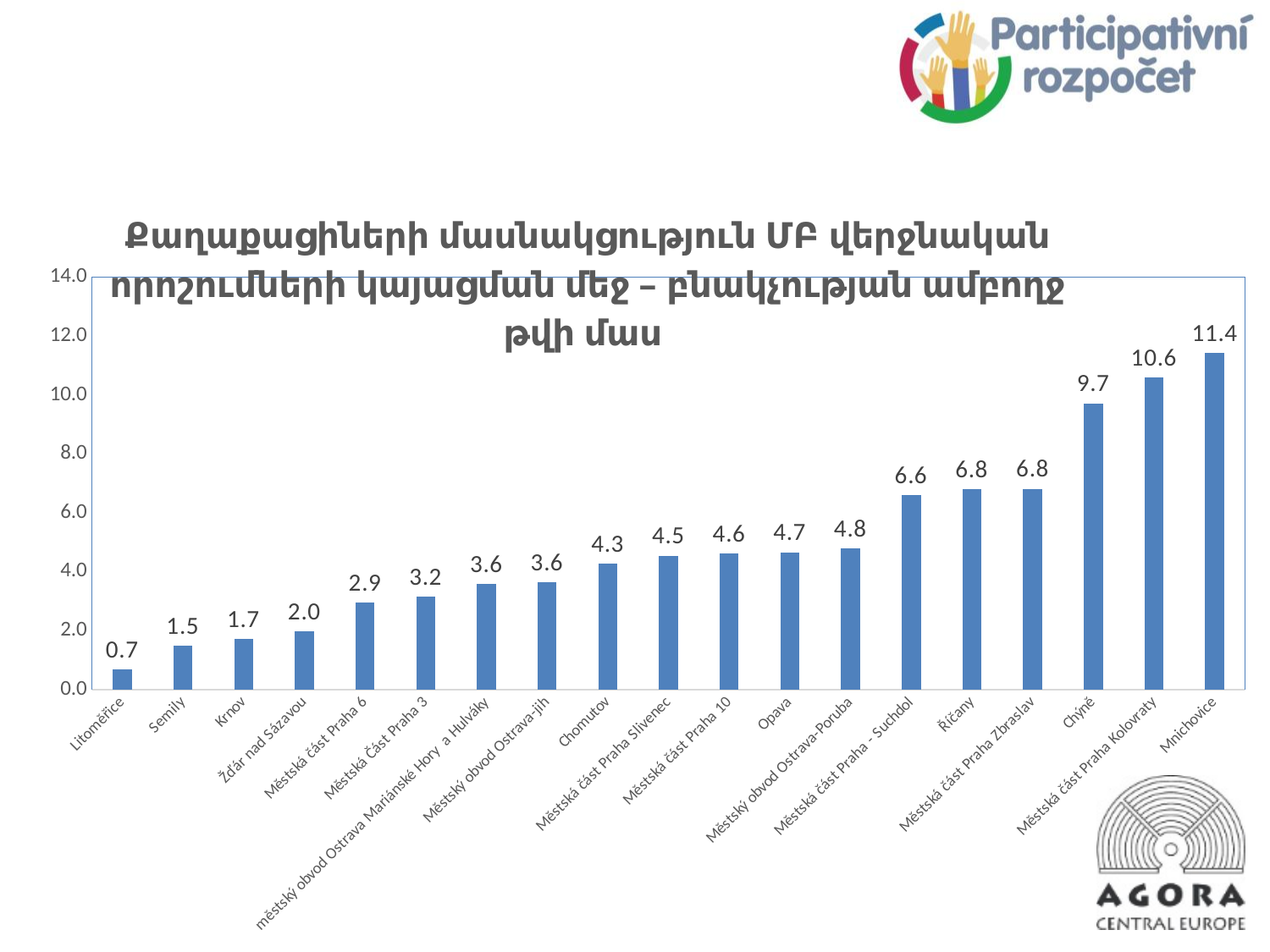
What is the value for Mnichovice? 11.4 What is the value for Chomutov? 4.3 Which category has the highest value? Mnichovice What is the value for Chýně? 9.7 How many categories are shown on the x axis? 19 Which is larger, the value for Krnov or the value for Žďár nad Sázavou? Žďár nad Sázavou What is the difference between the values for Semily and Litoměřice? 0.8 What is the value for Opava? 4.7 Do the values rise or fall from left to right along the x axis? Rise What is the difference between the values for Mnichovice and Městská část Praha Kolovraty? 0.8 Which category has the lowest value? Litoměřice What kind of chart is shown on the slide? Bar chart